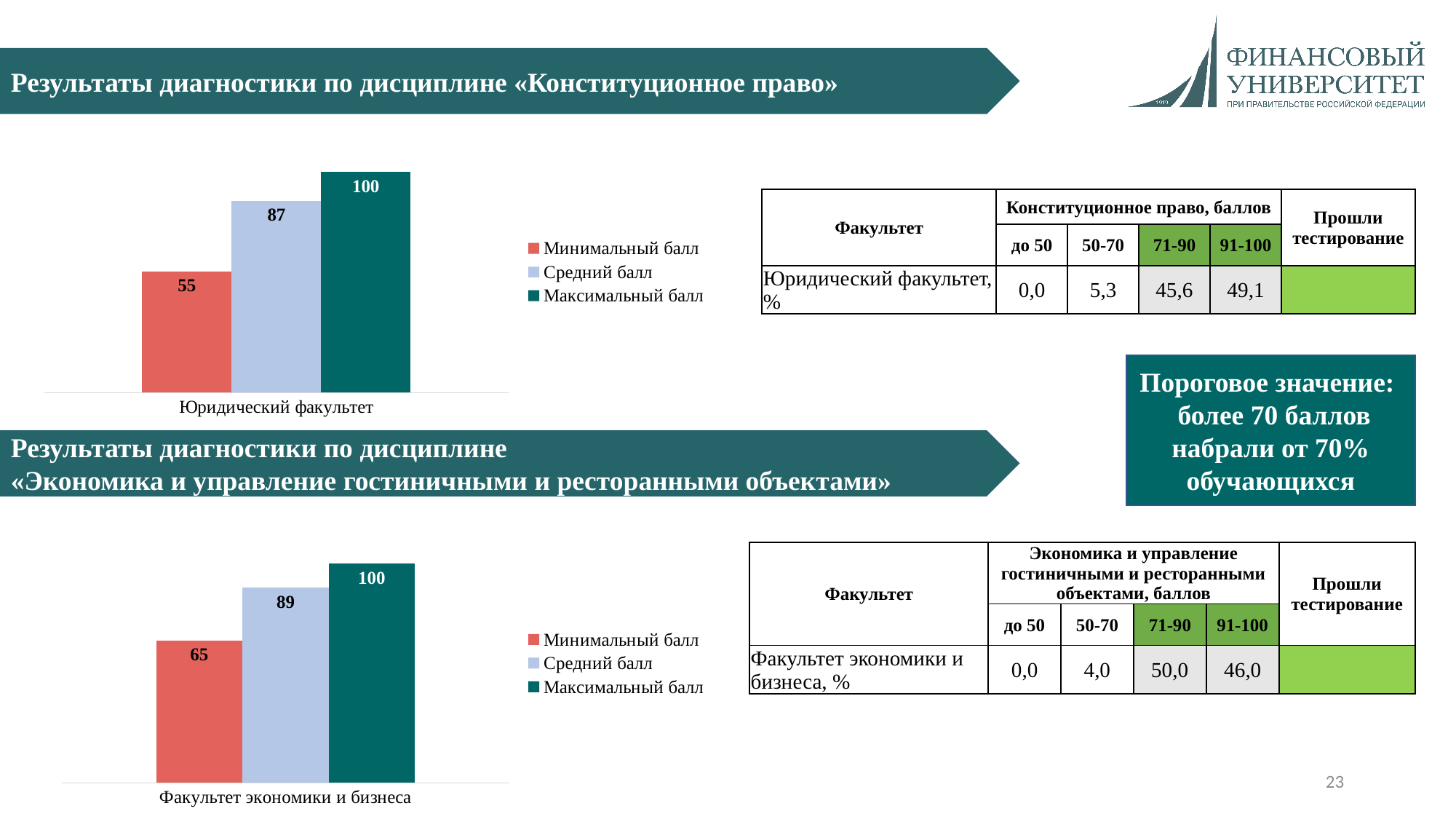
In the bottom chart, what is the difference between Средний балл and Минимальный балл? 24 In the top chart, what is the difference between Максимальный балл and Минимальный балл? 45 In the top chart, which series has the lowest value? Минимальный балл What kind of chart is the bottom chart? bar chart In the bottom chart, what is the value for Средний балл? 89 In the bottom chart, what is the value for Минимальный балл for Факультет экономики и бизнеса? 65 How many series does the legend of the top chart list? 3 In the bottom chart, which is larger: Средний балл or Минимальный балл? Средний балл In the top chart, what is the value for Средний балл? 87 In the bottom chart, which series has the highest value? Максимальный балл In the top chart, what is the value for Минимальный балл for Юридический факультет? 55 In the top chart, what is the value for Максимальный балл? 100